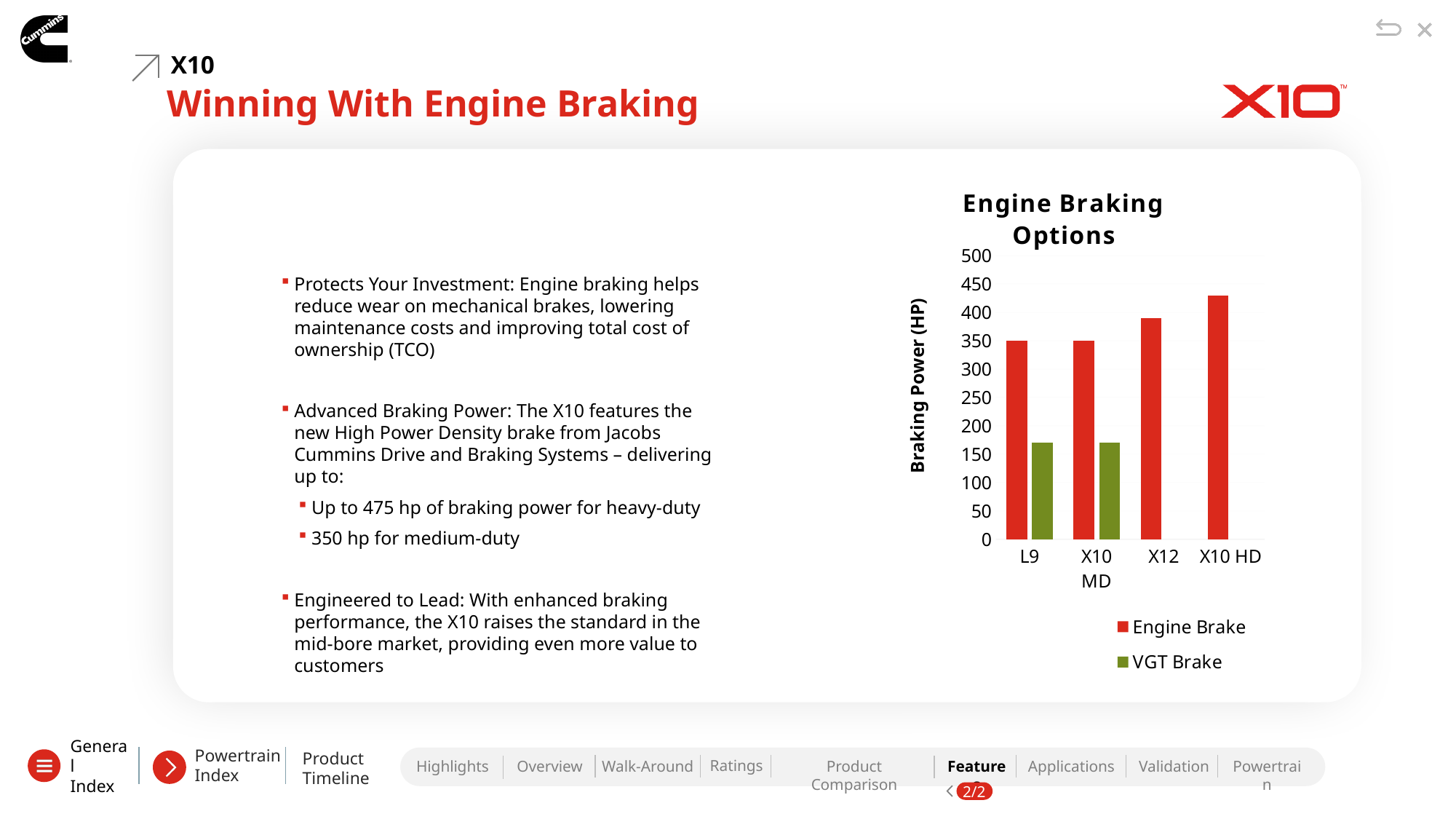
How many series does the chart legend list? 2 What is the title of the chart? Engine Braking Options How many engine categories are shown on the x axis of the chart? 4 What kind of chart is shown on the slide? bar chart Is the VGT Brake value for L9 greater or less than 200? less For L9, which is larger, the Engine Brake value or the VGT Brake value? Engine Brake Do the Engine Brake values rise or fall from L9 to X10 HD along the x axis? rise Which is larger, the Engine Brake value for X10 HD or for X12? X10 HD Is the Engine Brake value for X10 HD greater or less than 400? greater Is the Engine Brake value for X12 greater or less than 350? greater What is the label of the vertical axis of the chart? Braking Power (HP) Which engine has the highest Engine Brake value in the chart? X10 HD